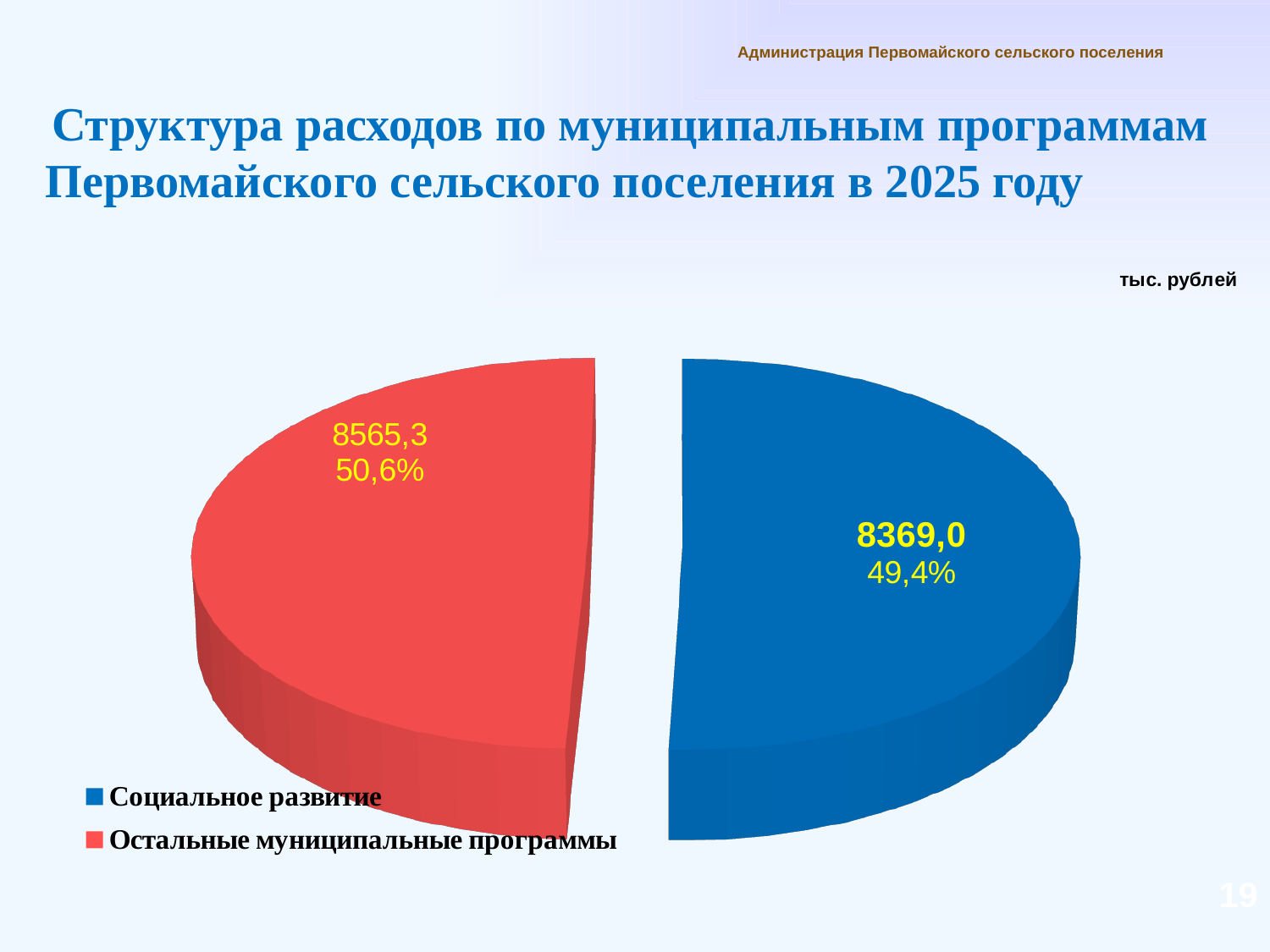
What share of the pie does "Остальные муниципальные программы" represent? 50,6% What type of chart is shown on the slide? pie chart Which category has the larger value? Остальные муниципальные программы What unit is indicated for the values on the chart? тыс. рублей What share of the pie does "Социальное развитие" represent? 49,4% How many slices does the pie chart have? 2 What value is shown for the "Социальное развитие" slice? 8369,0 What value is shown for the "Остальные муниципальные программы" slice? 8565,3 What is the total of the two slices shown on the chart? 16934,3 Which category has the smaller value? Социальное развитие Is the value for "Социальное развитие" larger or smaller than the value for "Остальные муниципальные программы"? smaller What is the difference between the values for "Остальные муниципальные программы" and "Социальное развитие"? 196,3